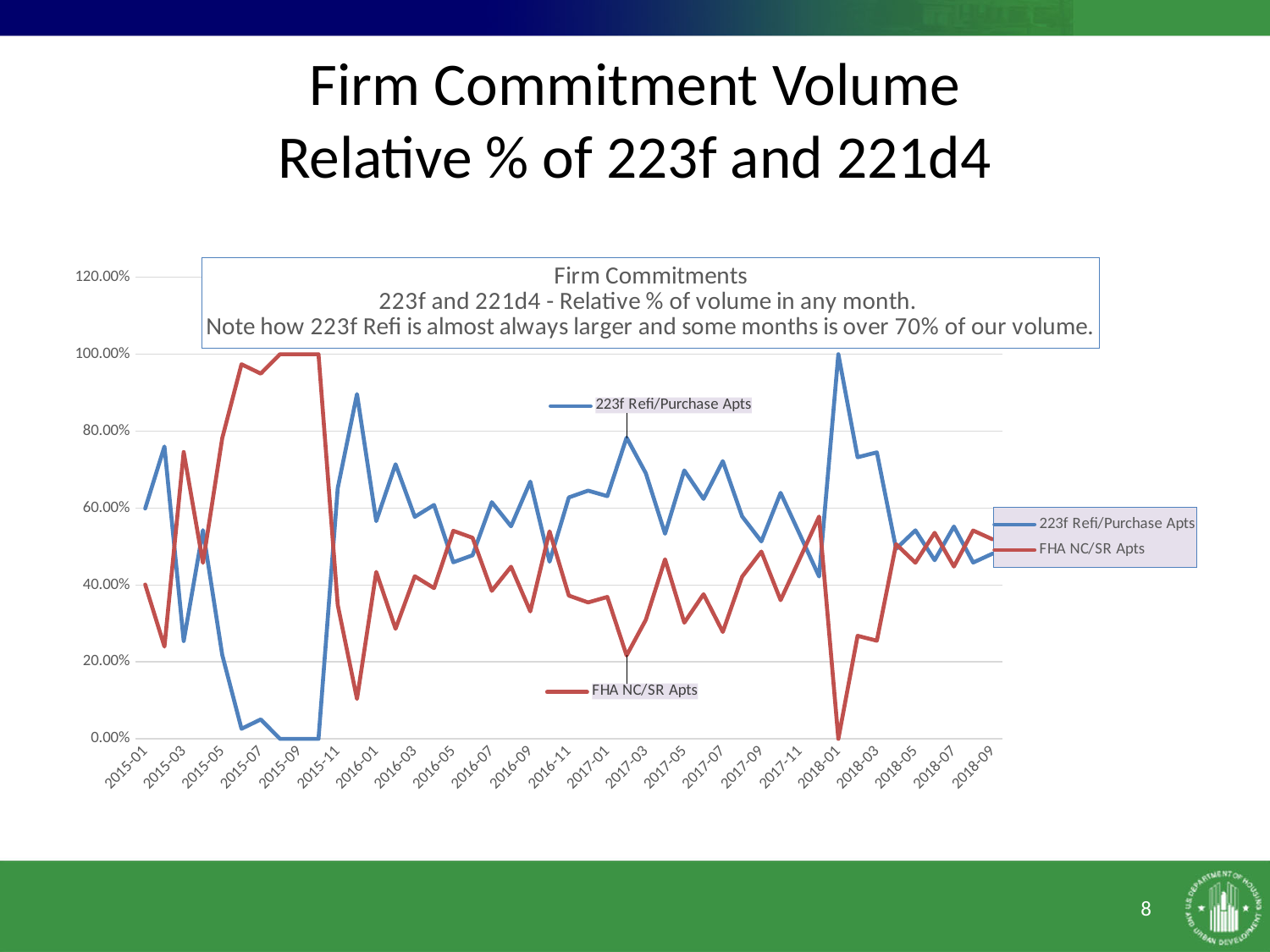
What is the maximum value reached by the FHA NC/SR Apts series? 100.00% How many series does the chart's legend list? 2 Is the value for FHA NC/SR Apts at 2016-01 greater or less than 20.00%? greater At 2015-09, which series has the higher value? FHA NC/SR Apts What type of chart is shown on the slide? line chart Is the value for 223f Refi/Purchase Apts at 2015-07 greater or less than 20.00%? less Is the value for 223f Refi/Purchase Apts at 2016-01 greater or less than 80.00%? less What is the value of the 223f Refi/Purchase Apts series at 2018-01? 100.00% What is the value of the 223f Refi/Purchase Apts series at 2015-09? 0.00% What are the two series named in the chart's legend? 223f Refi/Purchase Apts and FHA NC/SR Apts At 2018-01, which series has the higher value? 223f Refi/Purchase Apts What is the value of the FHA NC/SR Apts series at 2018-01? 0.00%